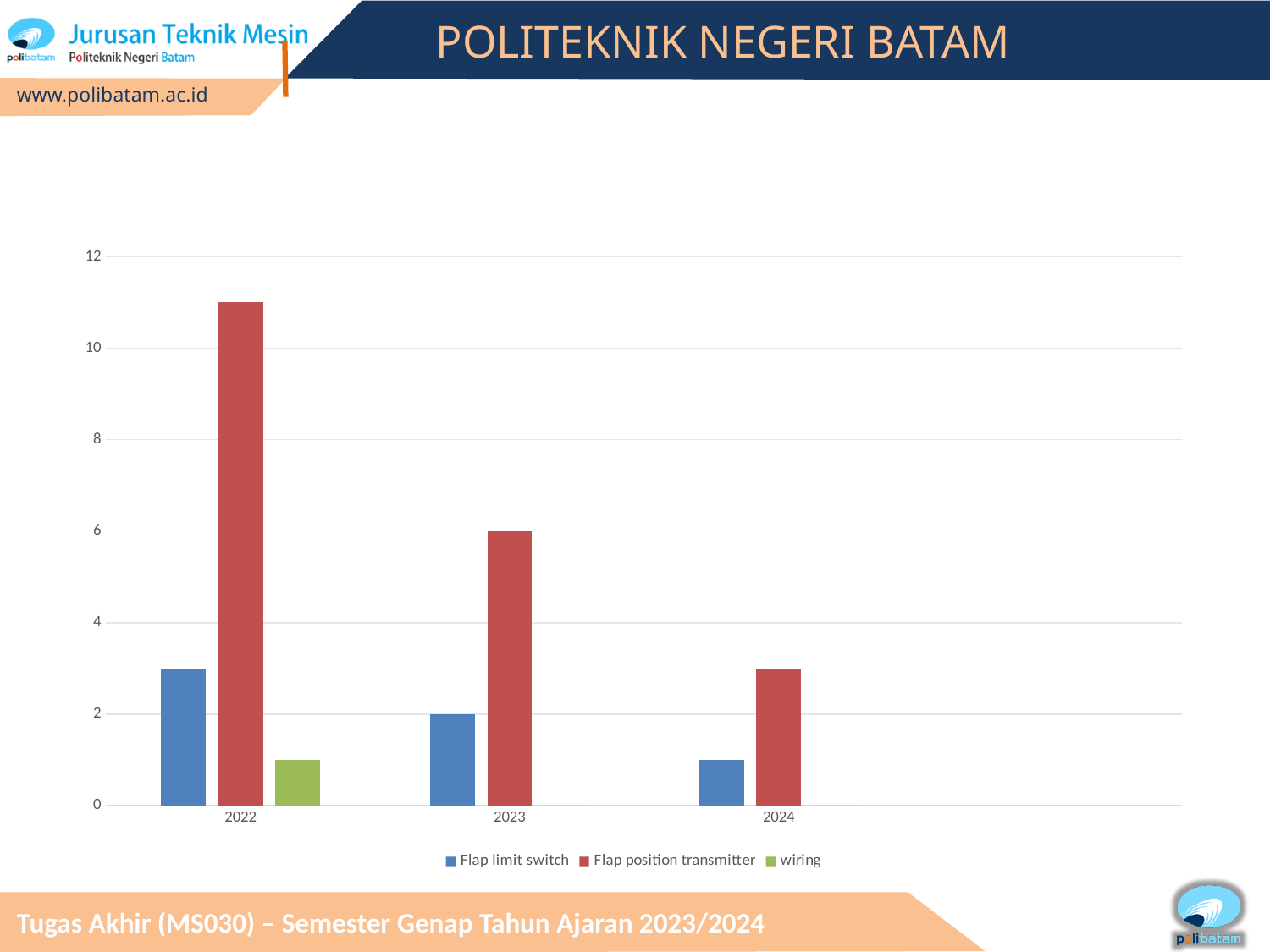
How many year categories are shown on the x axis? 3 Is the value for wiring in 2022 greater or less than 2? less What is the value for Flap position transmitter in 2023? 6 Is the value for Flap limit switch in 2022 greater or less than 4? less How many series does the legend list? 3 Does the value for Flap position transmitter rise or fall from 2022 to 2024? fall Which year has the highest value for Flap position transmitter? 2022 Which year has the lowest value for Flap limit switch? 2024 In 2024, which is larger: Flap limit switch or Flap position transmitter? Flap position transmitter What is the value for Flap limit switch in 2023? 2 Is the value for Flap position transmitter in 2022 greater or less than 10? greater What kind of chart is shown on the slide? bar chart